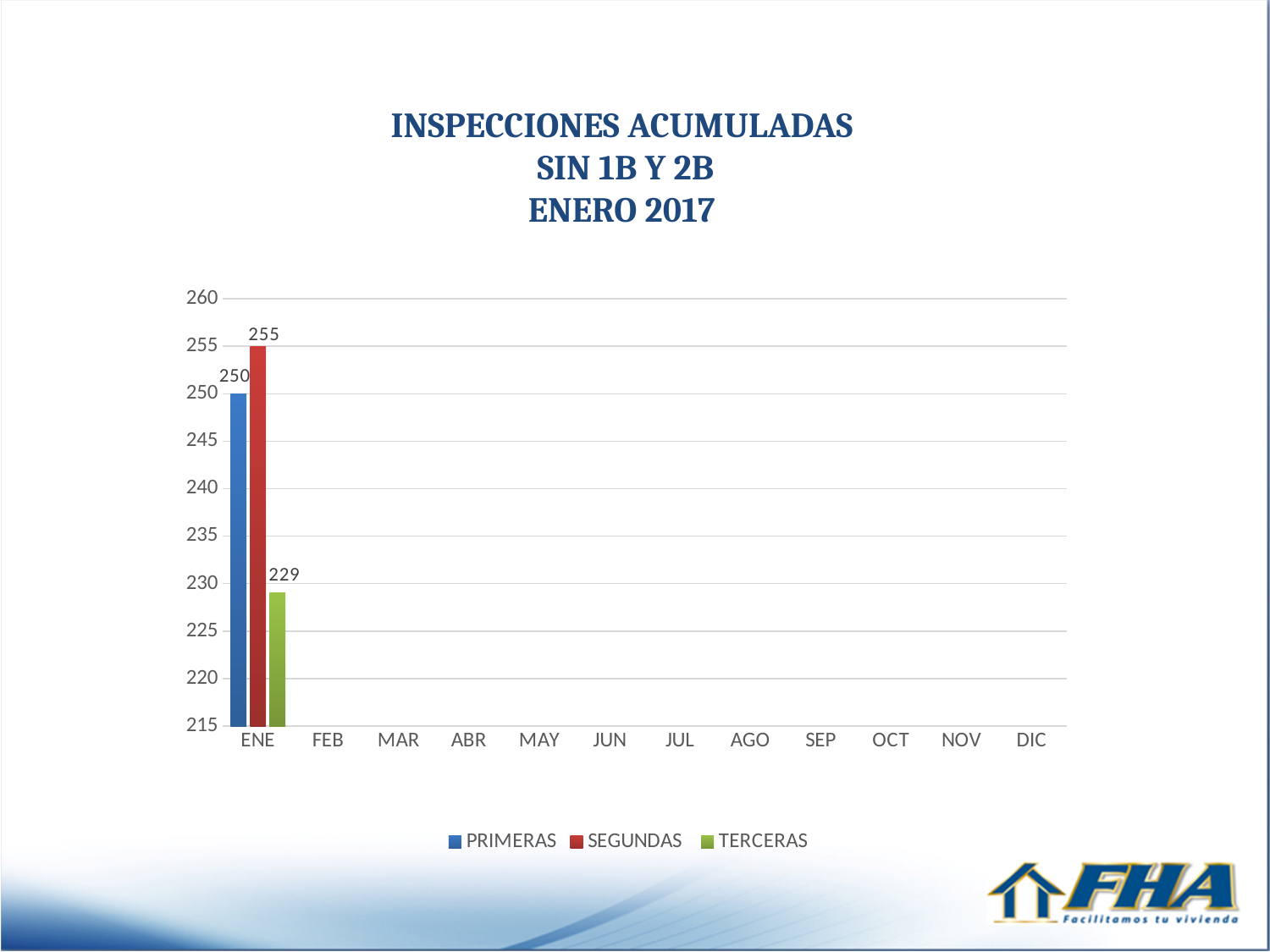
How many series does the legend list? 3 Is the value for TERCERAS in ENE greater or less than 230? less What is the value for SEGUNDAS in ENE? 255 Which is larger in ENE, PRIMERAS or TERCERAS? PRIMERAS What is the difference between PRIMERAS and TERCERAS in ENE? 21 What kind of chart is shown on the slide? bar chart What is the value for TERCERAS in ENE? 229 What is the value for PRIMERAS in ENE? 250 Which series has the lowest value in ENE? TERCERAS Which series has the highest value in ENE? SEGUNDAS What is the difference between SEGUNDAS and PRIMERAS in ENE? 5 How many month categories are shown on the x axis? 12